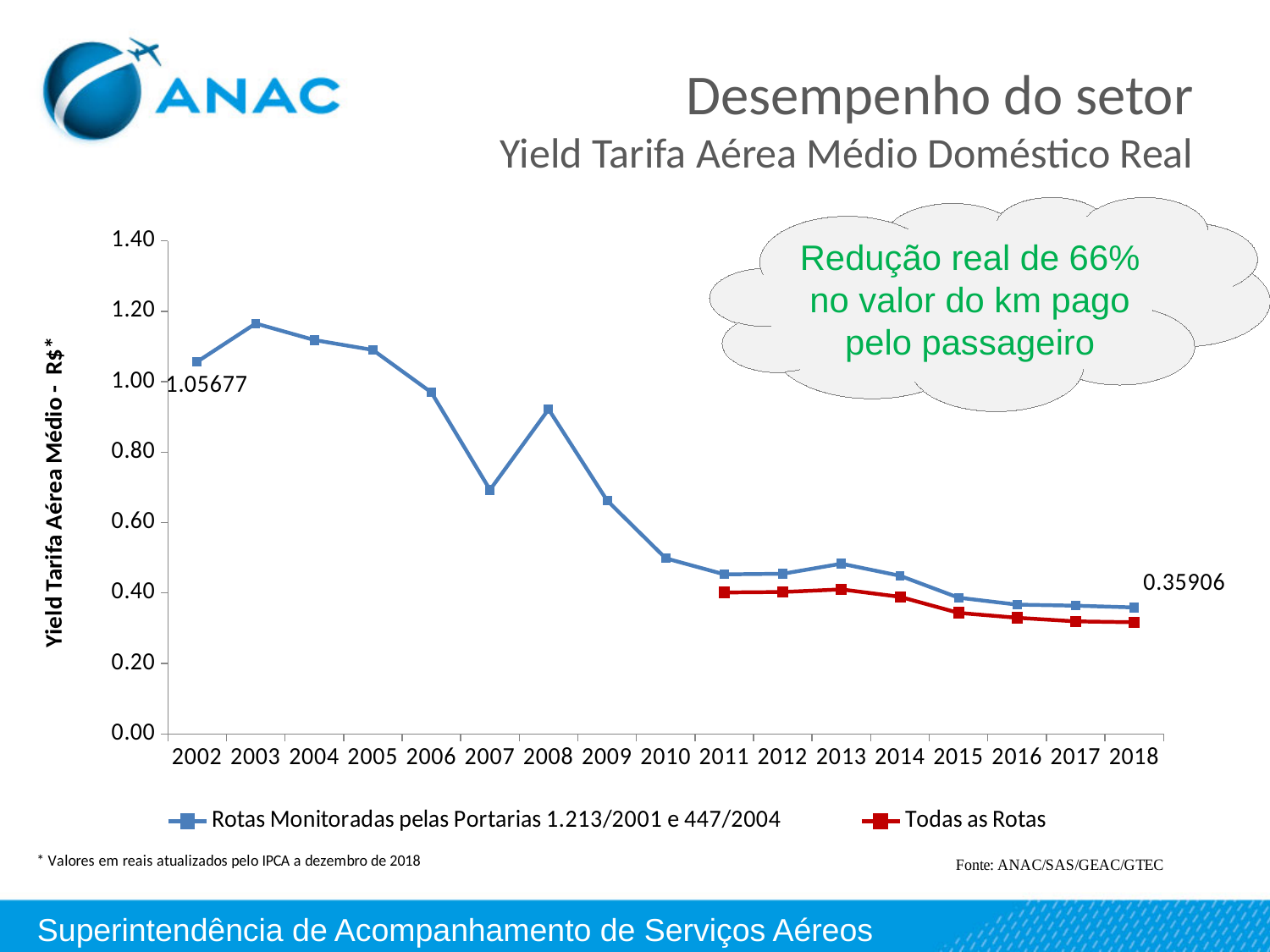
How many series does the legend list? 2 In which year does the Rotas Monitoradas series reach its highest value? 2003 Is the value for Todas as Rotas in 2015 greater or less than 0.40? less What type of chart is shown on the slide? Line chart In 2013, which series has the higher value, Rotas Monitoradas or Todas as Rotas? Rotas Monitoradas Is the value for Rotas Monitoradas in 2007 greater or less than 0.80? less What is the value for Rotas Monitoradas pelas Portarias 1.213/2001 e 447/2004 in 2002? 1.05677 How many years are shown on the x axis? 17 Overall, does the Rotas Monitoradas series rise or fall from 2002 to 2018? Fall What is the value for Rotas Monitoradas pelas Portarias 1.213/2001 e 447/2004 in 2018? 0.35906 What is the difference between the 2002 and 2018 values for Rotas Monitoradas pelas Portarias 1.213/2001 e 447/2004? 0.69771 Is the value for Rotas Monitoradas in 2008 greater or less than 0.80? greater